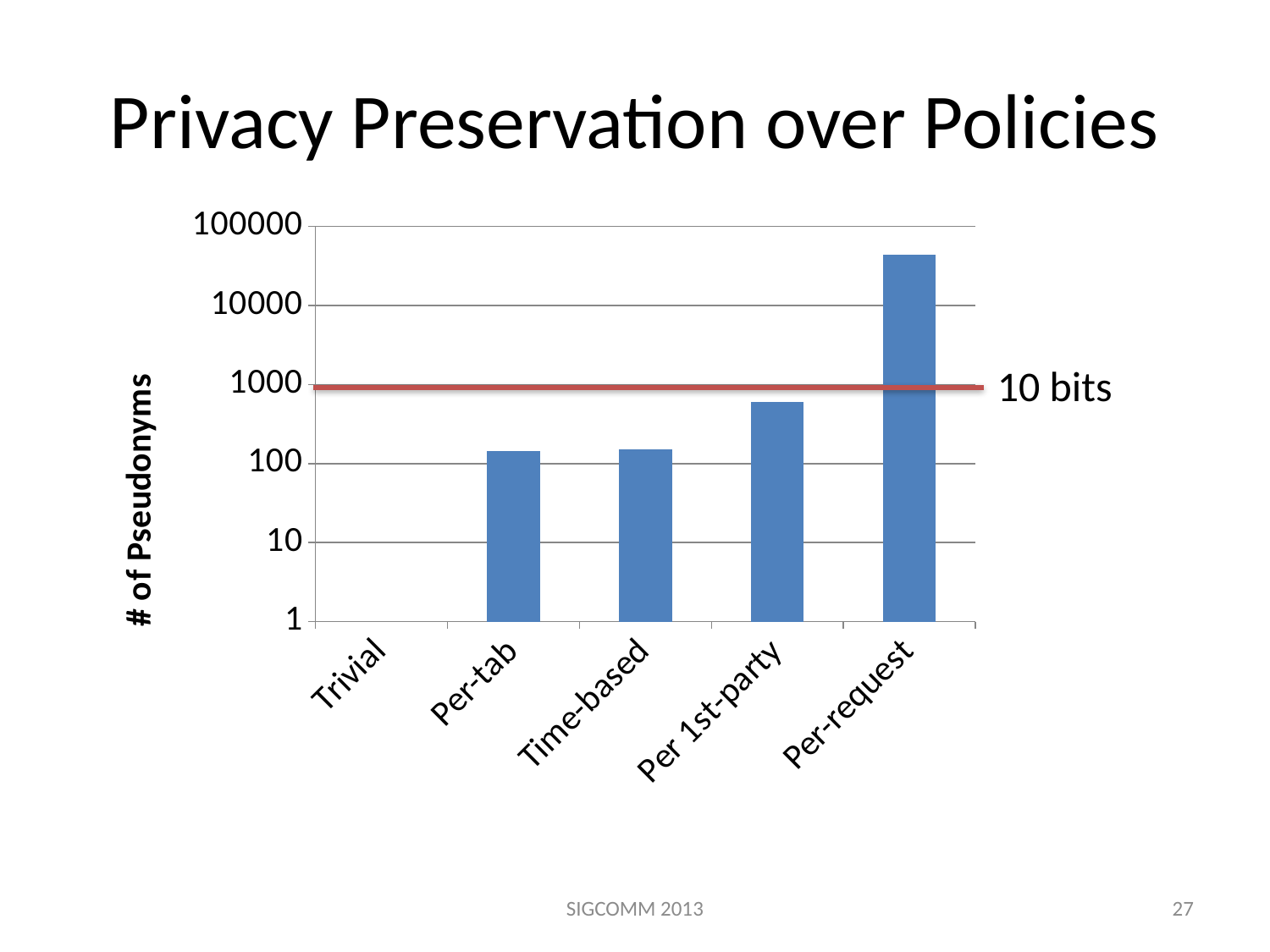
Do the values generally rise or fall moving from Trivial to Per-request along the x axis? rise What is the label on the horizontal red line across the chart? 10 bits Is the value for Per-request greater or less than 10000? greater Which has more pseudonyms, Per-request or Per 1st-party? Per-request Is the value for Per 1st-party greater or less than 1000? less Which policy has the lowest number of pseudonyms? Trivial Is the value for Time-based greater or less than 10? greater What kind of chart is shown on the slide? bar chart Which has more pseudonyms, Per 1st-party or Per-tab? Per 1st-party Which policy has the highest number of pseudonyms? Per-request How many policy categories are shown on the x axis? 5